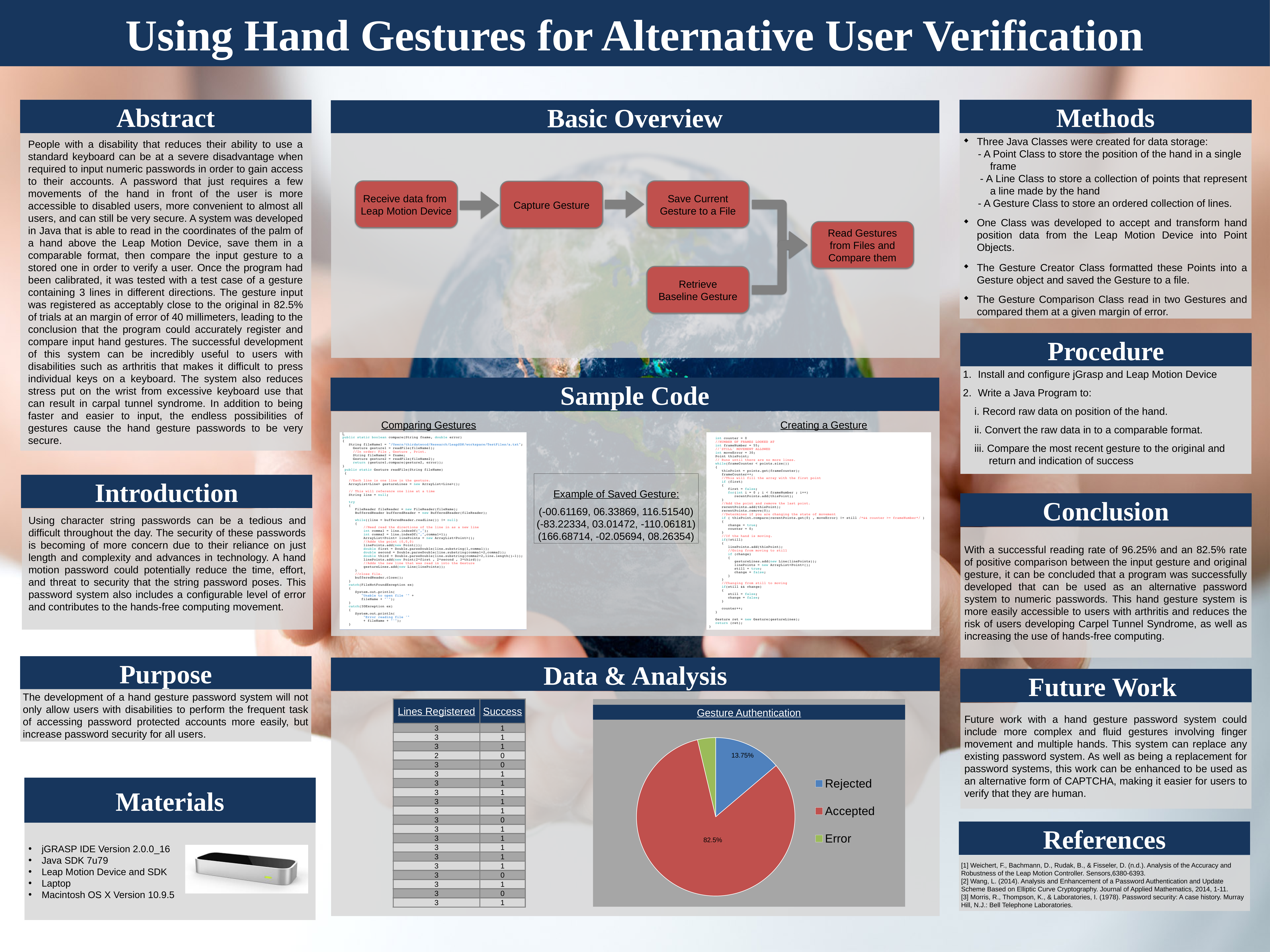
In the Gesture Authentication pie chart, what percentage of gestures were Accepted? 82.5% In the Gesture Authentication pie chart, which slice is larger, Rejected or Error? Rejected Which category has the largest slice in the Gesture Authentication pie chart? Accepted Which category has the smallest slice in the Gesture Authentication pie chart? Error What colour is the Accepted slice in the Gesture Authentication pie chart? red What kind of chart is shown in the Data & Analysis section? pie chart In the Gesture Authentication pie chart, what percentage of gestures were Rejected? 13.75% How many categories does the legend of the Gesture Authentication pie chart list? 3 In the Gesture Authentication pie chart, what is the difference in percentage points between the Accepted and Rejected slices? 68.75% What is the title of the pie chart? Gesture Authentication In the Gesture Authentication pie chart, which slice is larger, Accepted or Rejected? Accepted